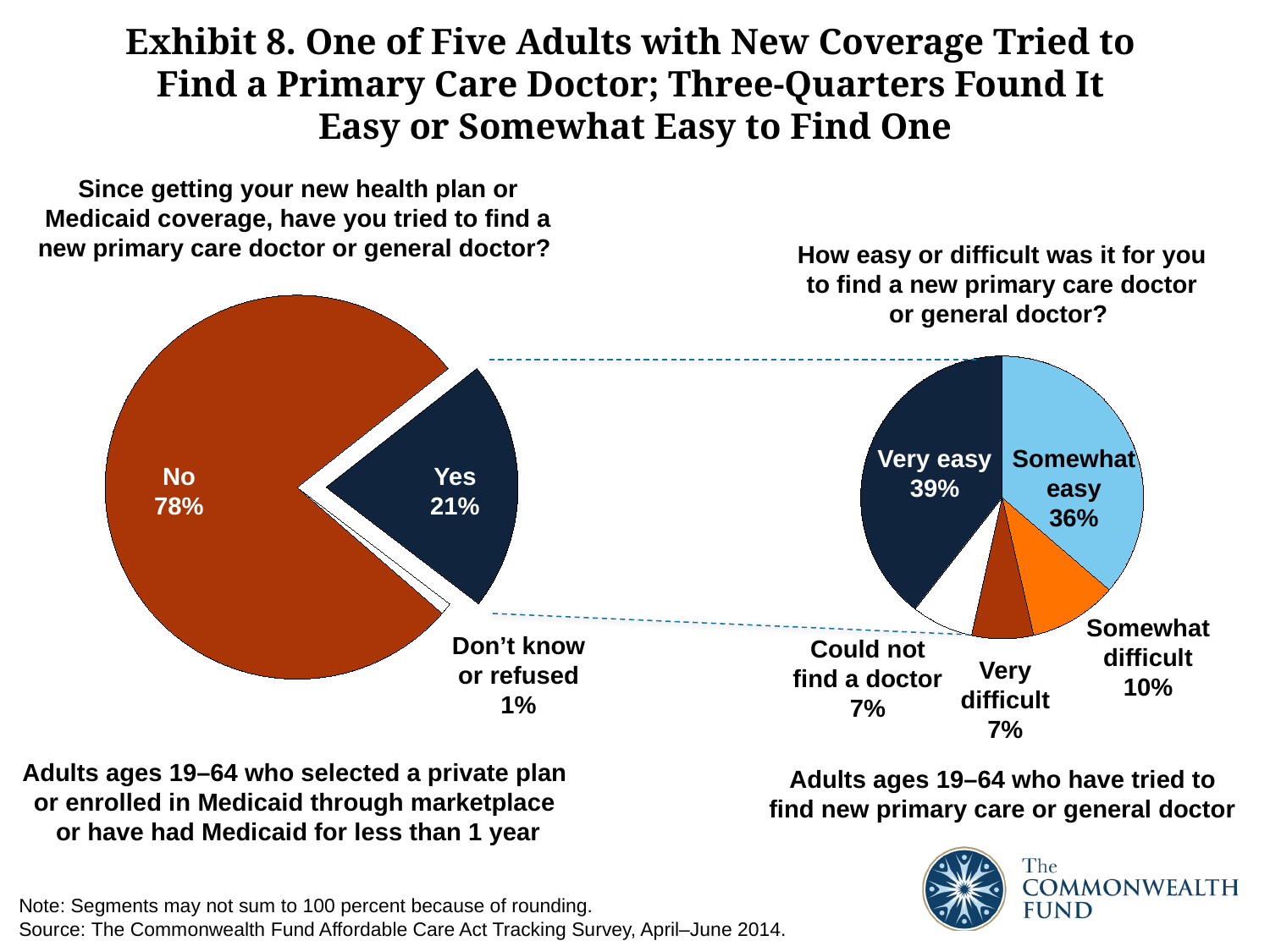
What type of chart is used on this slide? Pie chart In the right pie chart (how easy or difficult was it to find a doctor), which response has the largest share? Very easy In the left pie chart (have you tried to find a new primary care doctor), what percentage answered Yes? 21% In the right pie chart (how easy or difficult was it to find a doctor), what percentage said Very easy? 39% In the right pie chart (how easy or difficult was it to find a doctor), what is the difference in percentage points between Very easy and Somewhat easy? 3 In the right pie chart (how easy or difficult was it to find a doctor), which is larger: Somewhat difficult or Very difficult? Somewhat difficult In the left pie chart (have you tried to find a new primary care doctor), what percentage answered No? 78% In the right pie chart (how easy or difficult was it to find a doctor), what percentage said Somewhat difficult? 10% In the left pie chart (have you tried to find a new primary care doctor), what share is Don't know or refused? 1% In the right pie chart (how easy or difficult was it to find a doctor), how many segments are there? 5 In the left pie chart (have you tried to find a new primary care doctor), how many segments are there? 3 In the left pie chart (have you tried to find a new primary care doctor), what is the difference in percentage points between No and Yes? 57